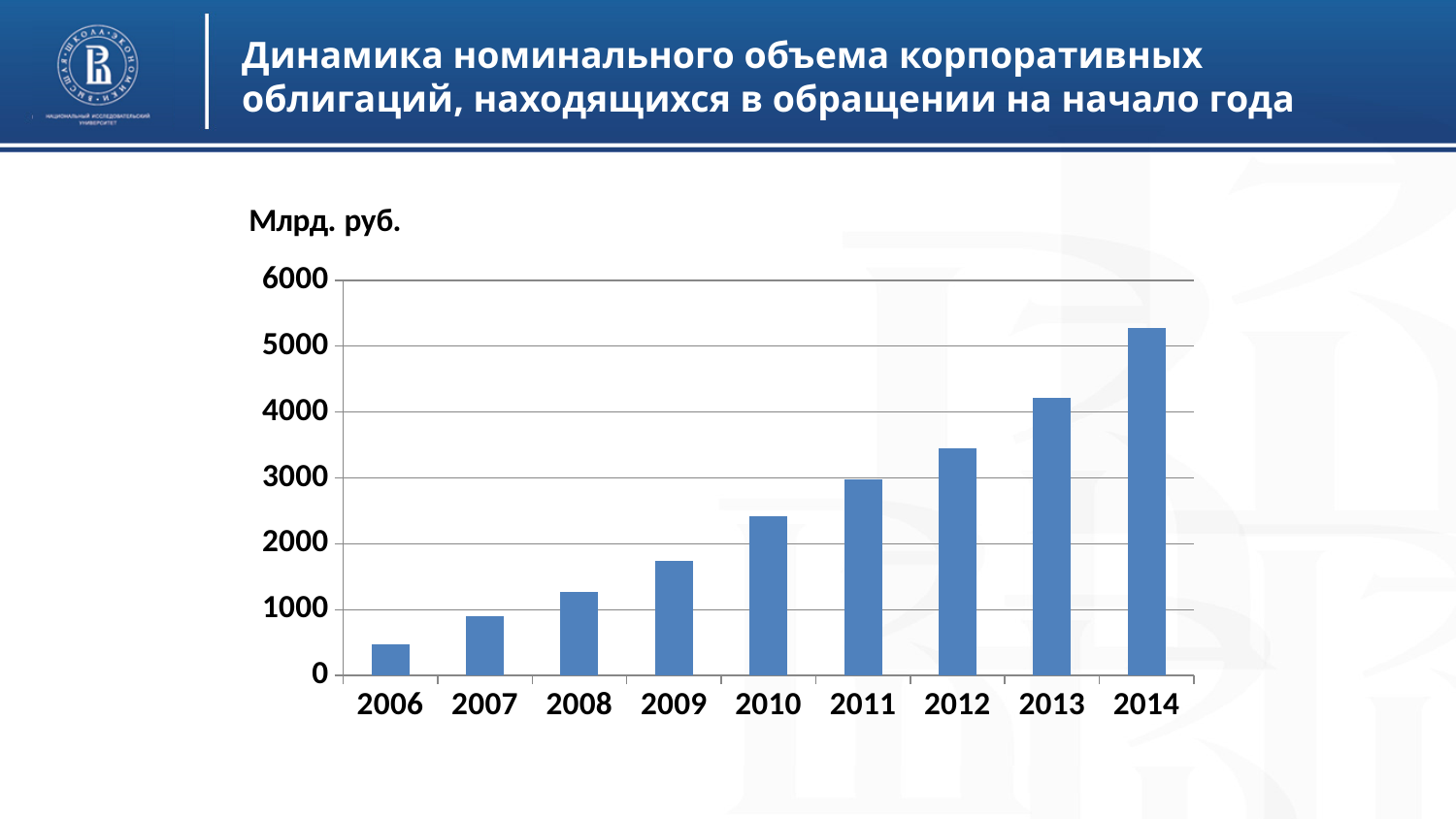
Which is larger, the value for 2013 or the value for 2012? 2013 Is the value for 2012 greater or less than 4000? less How many years are shown on the x axis of the chart? 9 Is the value for 2010 greater or less than 2000? greater What unit is shown above the y axis of the chart? Млрд. руб. Which year has the lowest bar in the chart? 2006 Is the value for 2007 greater or less than 1000? less Do the values rise or fall from 2006 to 2014? rise What kind of chart is shown on the slide? bar chart Which year has the highest bar in the chart? 2014